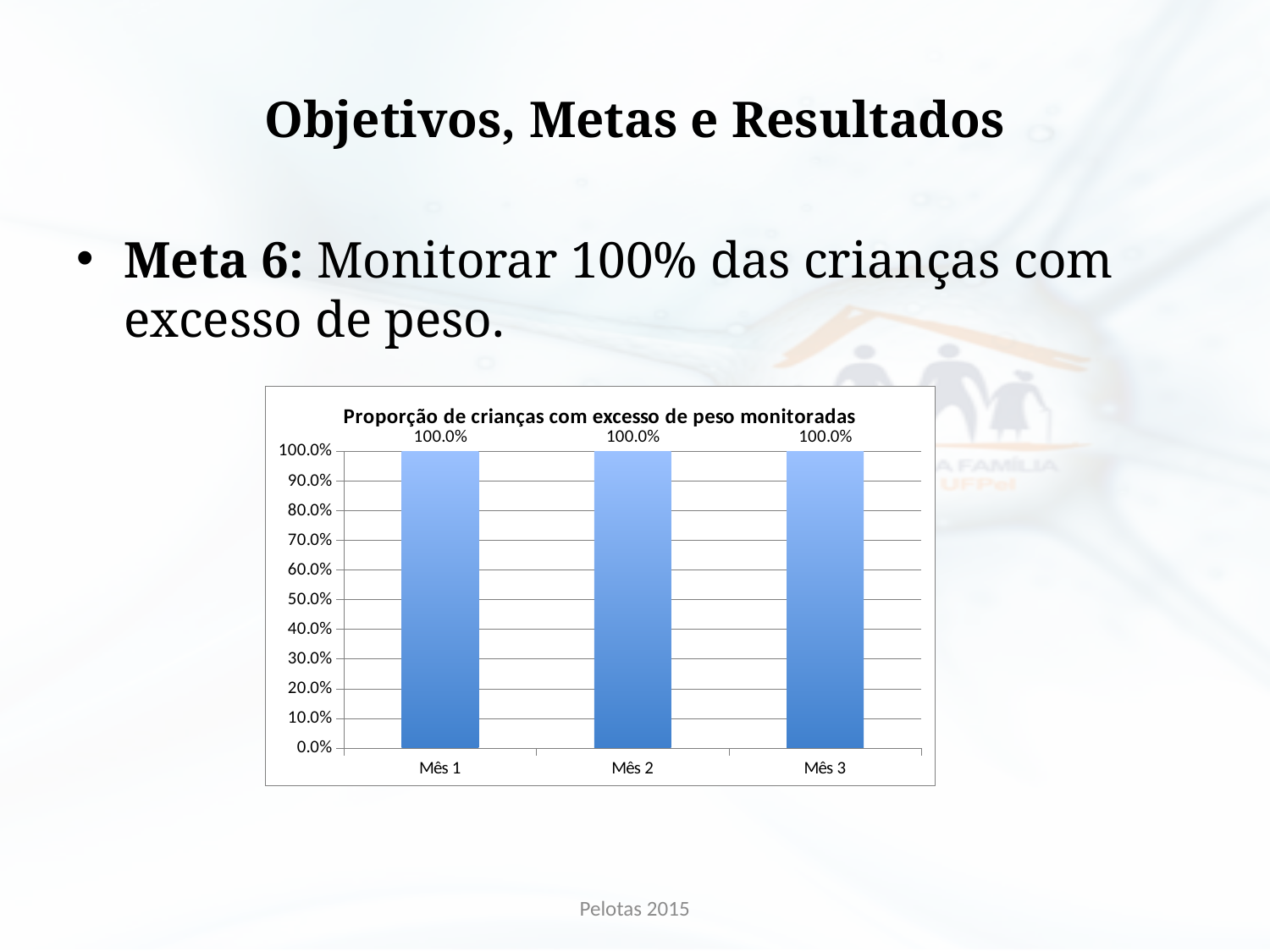
What kind of chart is shown on the slide? Bar chart What is the highest value shown on the y axis of the chart? 100.0% What is the difference between the values for Mês 1 and Mês 3? 0.0% What is the value for Mês 2 in the chart? 100.0% What is the value for Mês 1 in the chart? 100.0% What is the value for Mês 3 in the chart? 100.0% Do the values rise, fall or stay the same from Mês 1 to Mês 3? Stay the same Is the value for Mês 2 larger than, smaller than, or equal to the value for Mês 3? Equal What is the title of the chart? Proporção de crianças com excesso de peso monitoradas How many categories are shown on the x axis of the chart? 3 Is the value for Mês 1 greater or less than 90.0%? greater